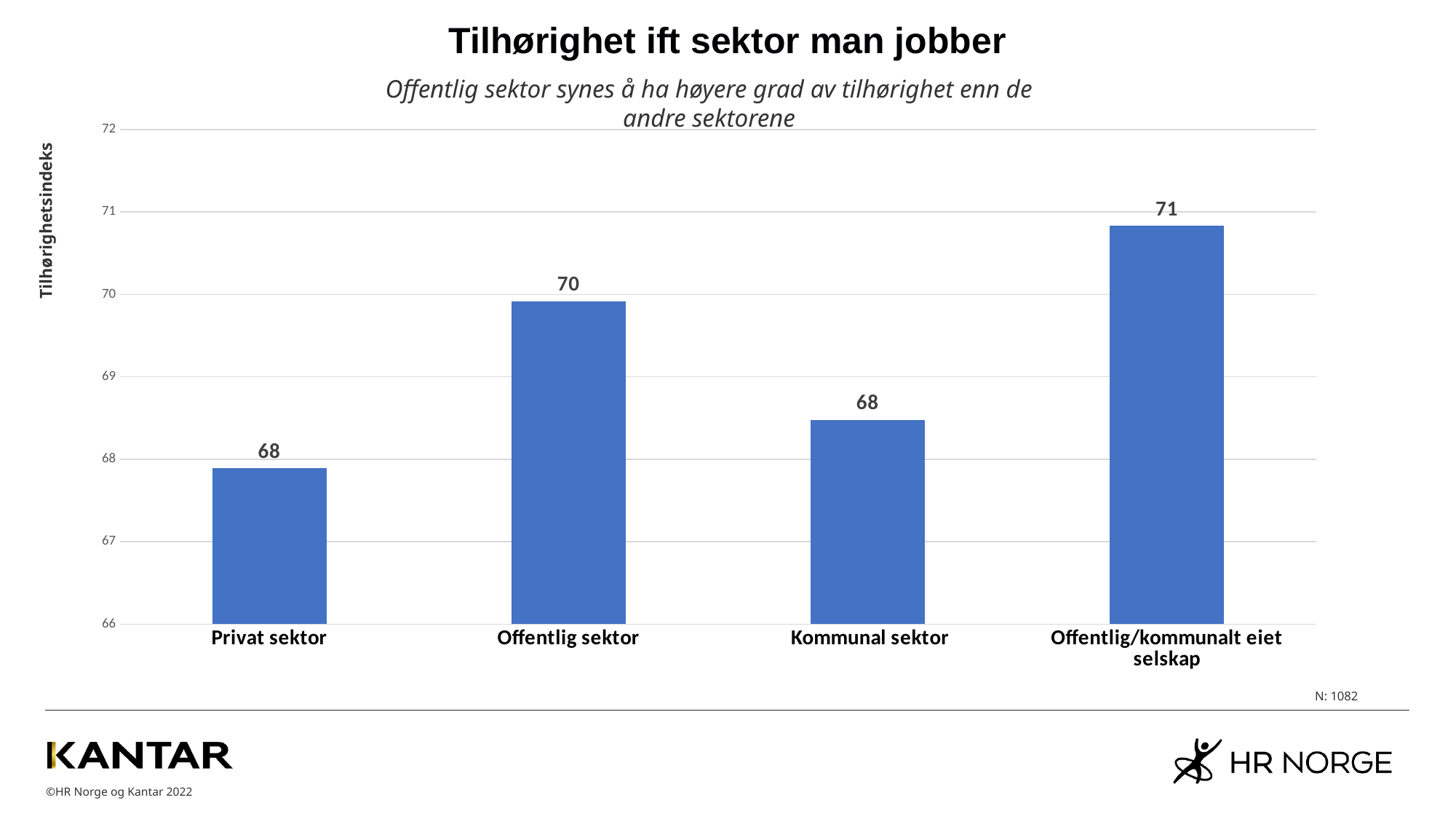
What is the difference between the values for Offentlig/kommunalt eiet selskap and Privat sektor? 3 What is the value for Privat sektor? 68 What is the value for Offentlig/kommunalt eiet selskap? 71 Which sector has the highest value? Offentlig/kommunalt eiet selskap What is the title of the chart? Tilhørighet ift sektor man jobber What kind of chart is shown on the slide? bar chart What is the difference between the values for Offentlig/kommunalt eiet selskap and Offentlig sektor? 1 Is the value for Kommunal sektor greater or less than 69? less Which is larger, the value for Offentlig sektor or the value for Kommunal sektor? Offentlig sektor How many sectors are shown on the chart? 4 What is the value for Offentlig sektor? 70 What is the value for Kommunal sektor? 68